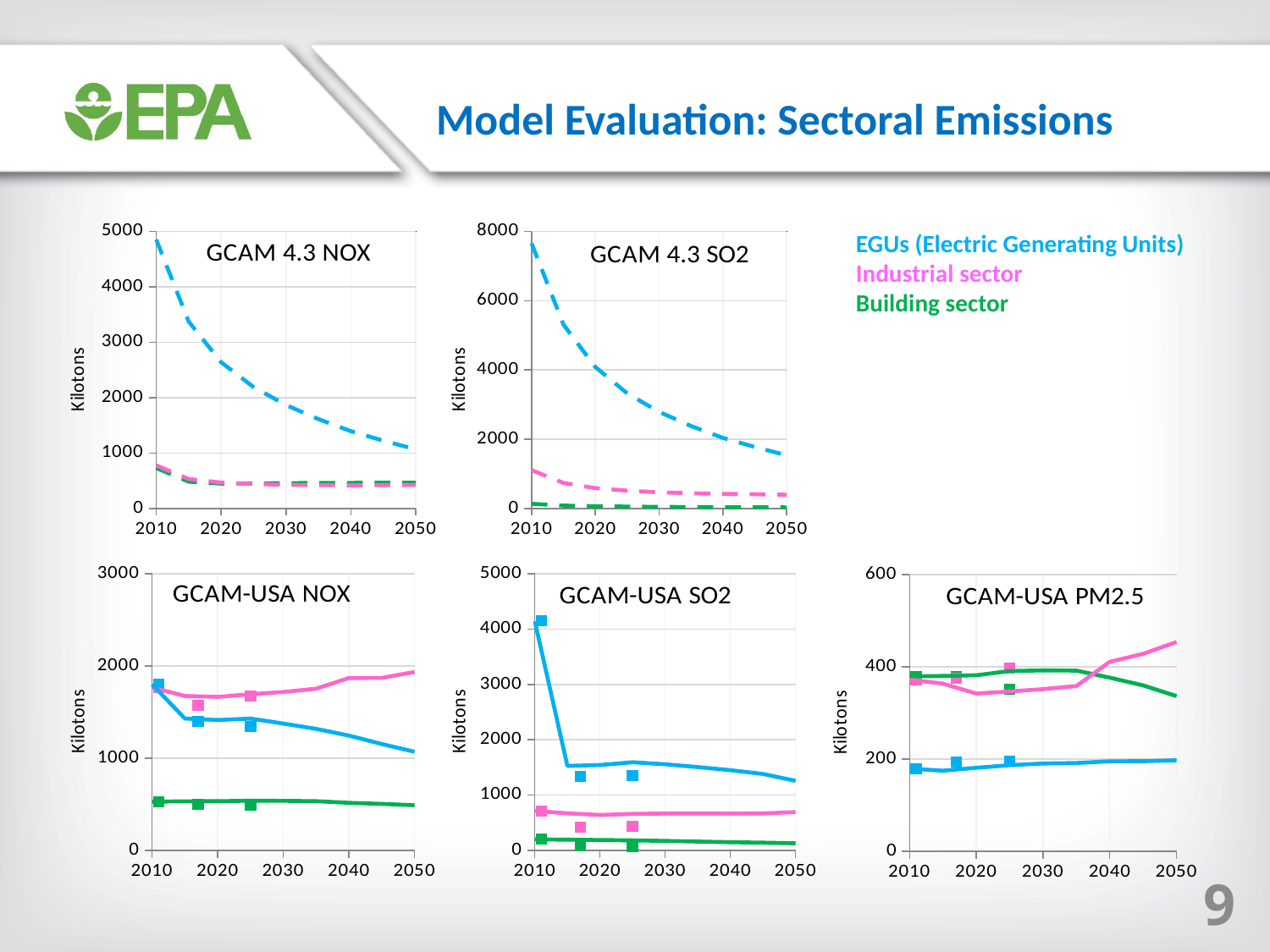
In the GCAM-USA PM2.5 chart, does the Industrial sector line rise or fall between 2030 and 2050? rise What kind of chart is the GCAM 4.3 NOX chart? line chart In the GCAM-USA SO2 chart, is the EGU line value in 2050 greater or less than 2000? less In the GCAM-USA PM2.5 chart, is the EGU value in 2050 greater or less than 400? less How many sectors does the legend on the slide list? 3 In the GCAM-USA NOX chart, which sector has the highest emissions in 2050? Industrial sector In the GCAM 4.3 NOX chart, is the EGU value in 2010 greater or less than 4000? greater In the GCAM 4.3 SO2 chart, do EGU emissions rise or fall from 2010 to 2050? fall What is the y-axis label used on the charts? Kilotons In the GCAM 4.3 SO2 chart, which is higher in 2010, the Industrial sector or the Building sector? Industrial sector In the GCAM-USA NOX chart, which sector has the lowest emissions across the whole period? Building sector